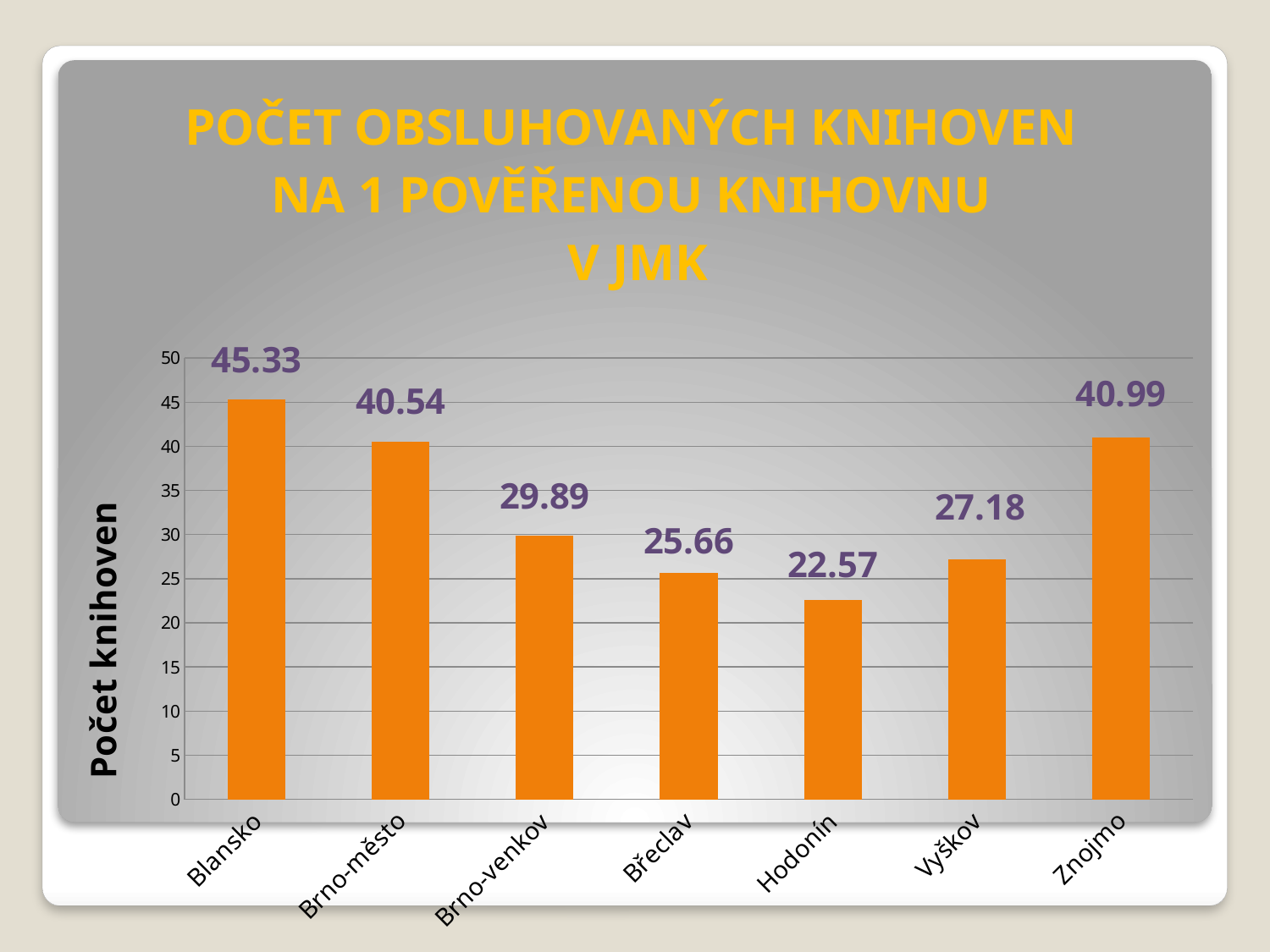
What is the value for Znojmo? 40.99 What is the value for Vyškov? 27.18 What is the value for Blansko? 45.33 What is the label of the vertical axis? Počet knihoven What is the difference between the values for Blansko and Brno-město? 4.79 What kind of chart is shown on the slide? bar chart What is the value for Hodonín? 22.57 How many categories are shown on the x axis? 7 Which category has the highest value? Blansko Is the value for Znojmo greater or less than 40? greater Which category has the lowest value? Hodonín Which is larger, the value for Brno-venkov or the value for Břeclav? Brno-venkov